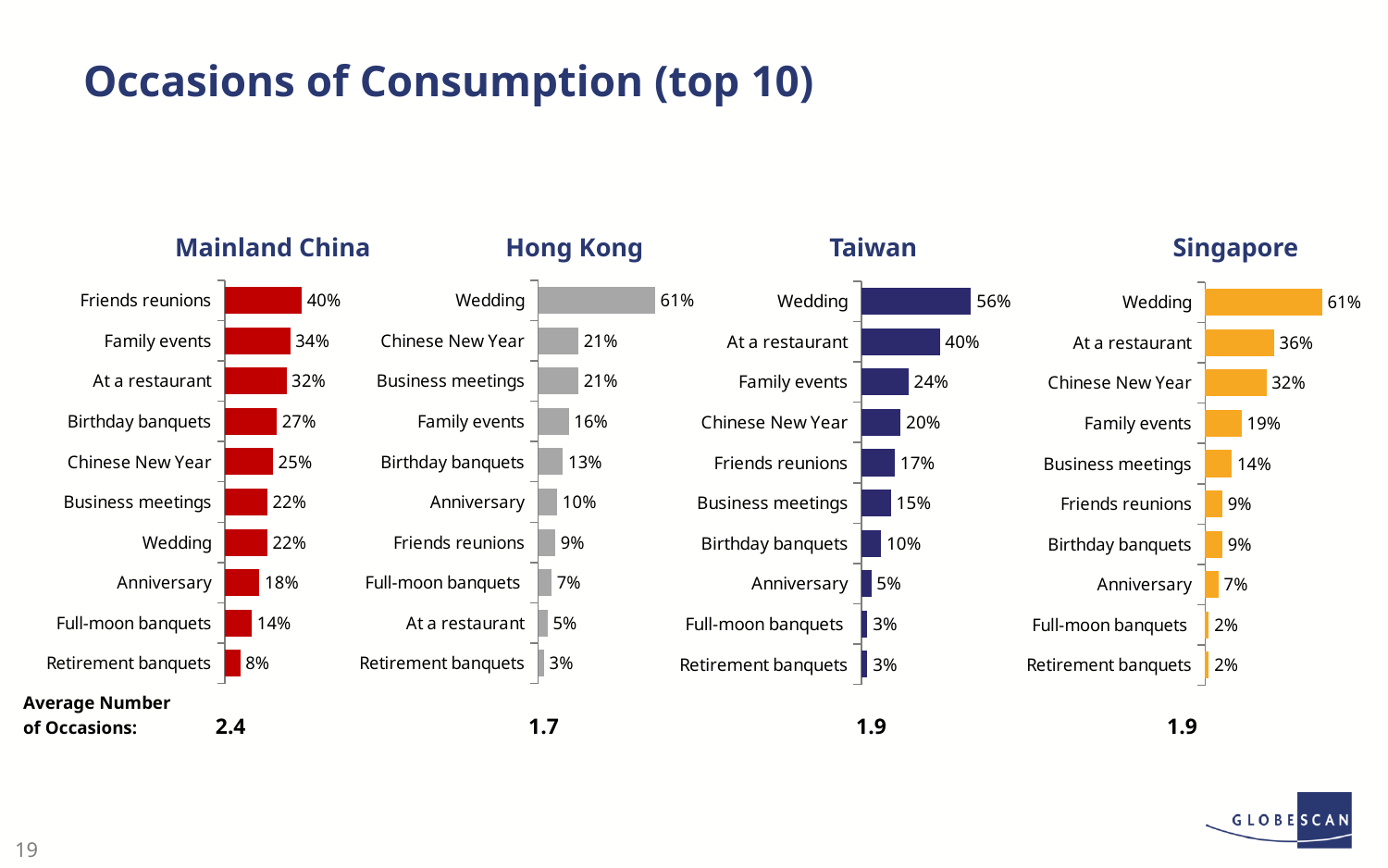
How many occasions are shown in the Taiwan chart? 10 What kind of chart is the Mainland China chart? Bar chart In the Taiwan chart, which occasion has the highest value? Wedding In the Hong Kong chart, which is larger: the value for Family events or the value for Birthday banquets? Family events In the Mainland China chart, what is the value for Friends reunions? 40% What is the Average Number of Occasions shown for Mainland China? 2.4 In the Hong Kong chart, what is the value for Wedding? 61% In the Singapore chart, what is the difference between the values for Wedding and At a restaurant? 25% In the Mainland China chart, which occasion has the lowest value? Retirement banquets What colour are the bars in the Singapore chart? Orange In the Singapore chart, what is the value for Chinese New Year? 32% In the Taiwan chart, what is the value for At a restaurant? 40%